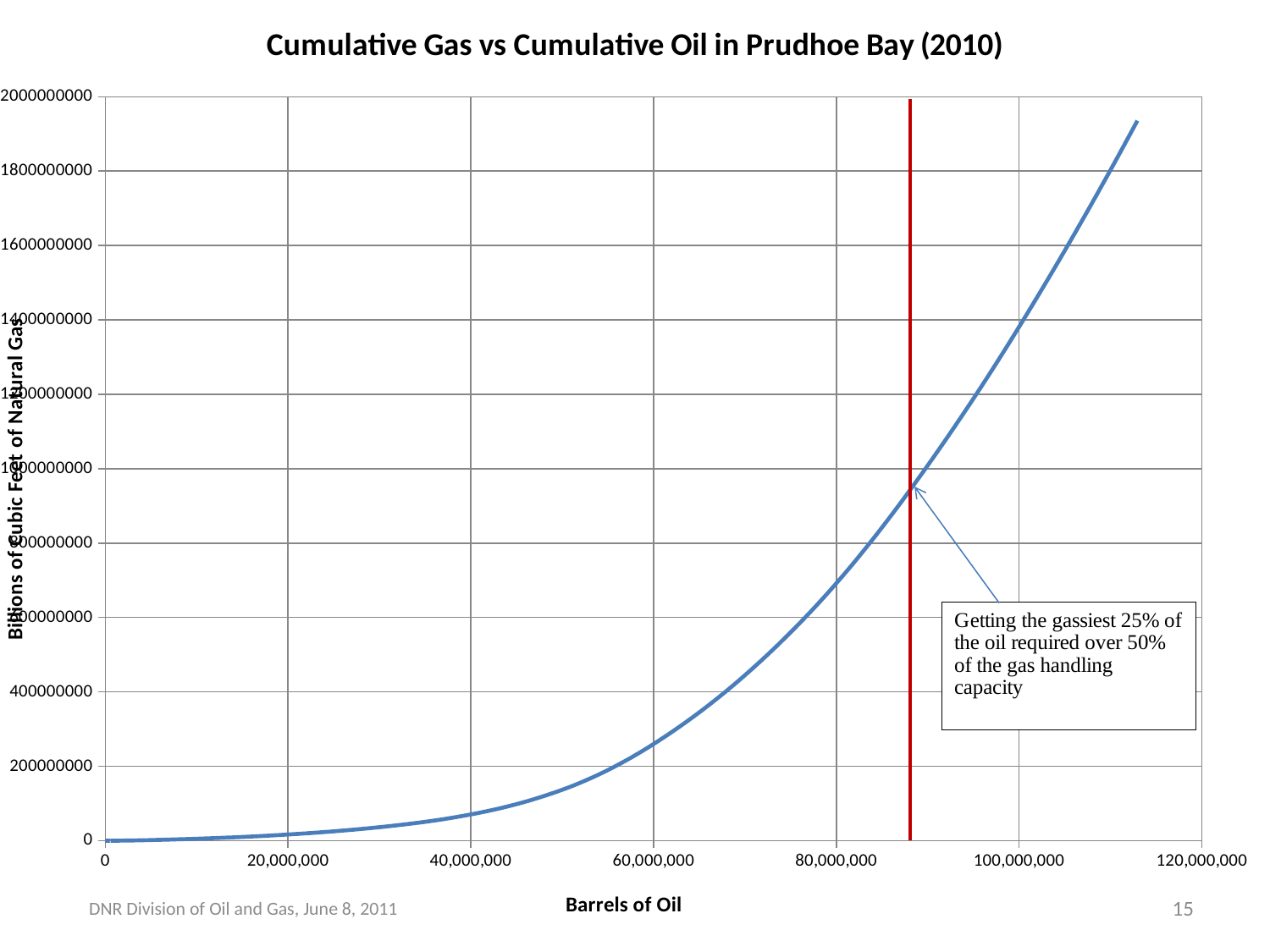
Do the values of the line rise or fall as Barrels of Oil increases along the x axis? rise Is the value of the line at 80,000,000 Barrels of Oil greater or less than 400000000? greater Is the value of the line at 20,000,000 Barrels of Oil greater or less than 200000000? less Is the value of the line at 100,000,000 Barrels of Oil larger or smaller than its value at 60,000,000 Barrels of Oil? larger What is the label of the x axis? Barrels of Oil Is the value of the line at 100,000,000 Barrels of Oil greater or less than 1200000000? greater What kind of chart is shown on the slide? line chart What is the title of the chart? Cumulative Gas vs Cumulative Oil in Prudhoe Bay (2010)